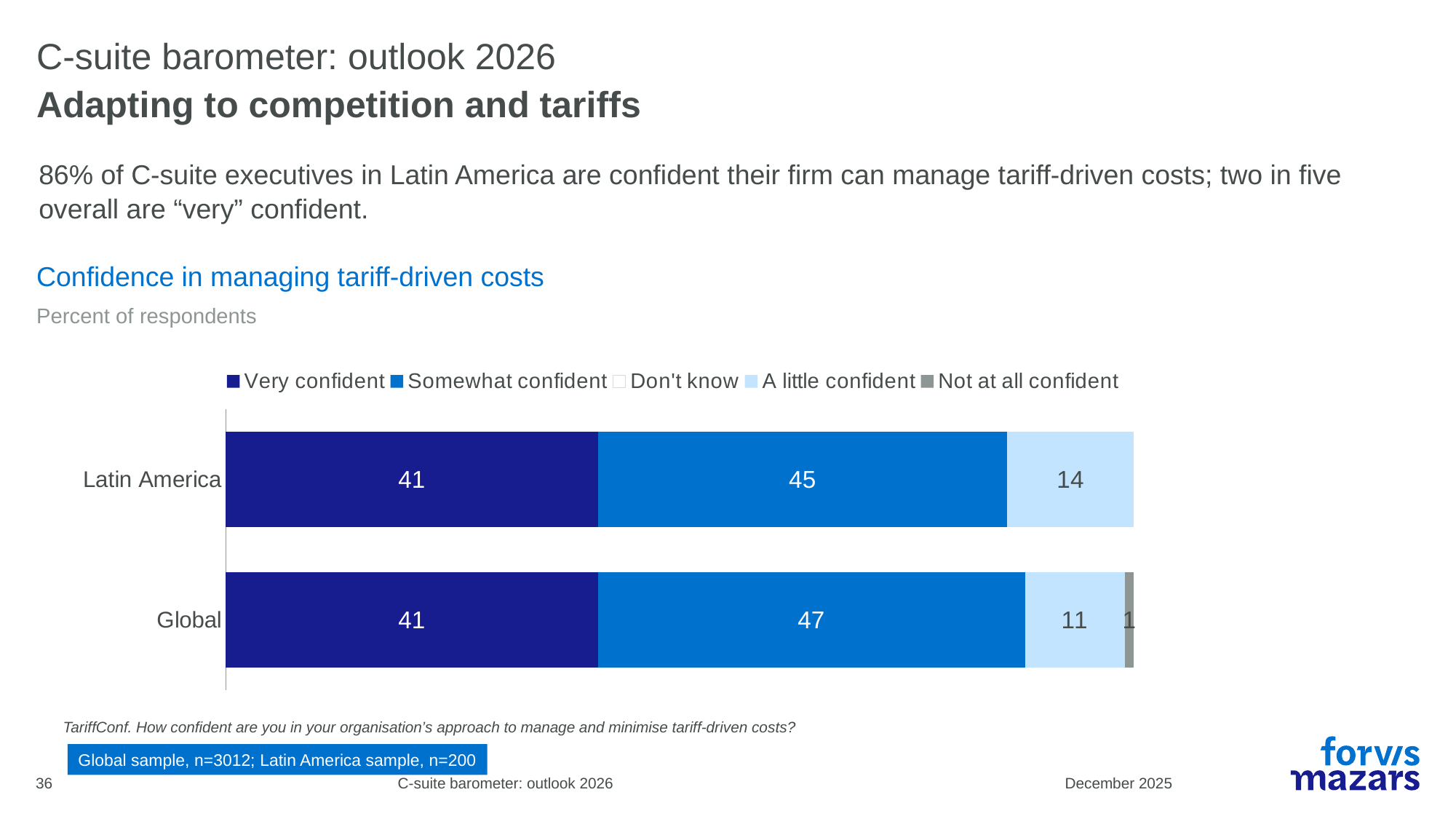
What percentage of Latin America respondents are "Very confident" in managing tariff-driven costs? 41 What is the "Not at all confident" value for Global? 1 What kind of chart is shown on the slide? Stacked bar chart What is the difference between the "A little confident" values for Latin America and Global? 3 How many series does the legend list? 5 What is the difference between the "Somewhat confident" values for Global and Latin America? 2 What is the "Somewhat confident" value for Global? 47 What is the "A little confident" value for Latin America? 14 What is the title of the chart? Confidence in managing tariff-driven costs How many categories (regions) are shown on the chart? 2 Which series is the largest segment in the Latin America bar? Somewhat confident Which category has the higher "Somewhat confident" value, Latin America or Global? Global